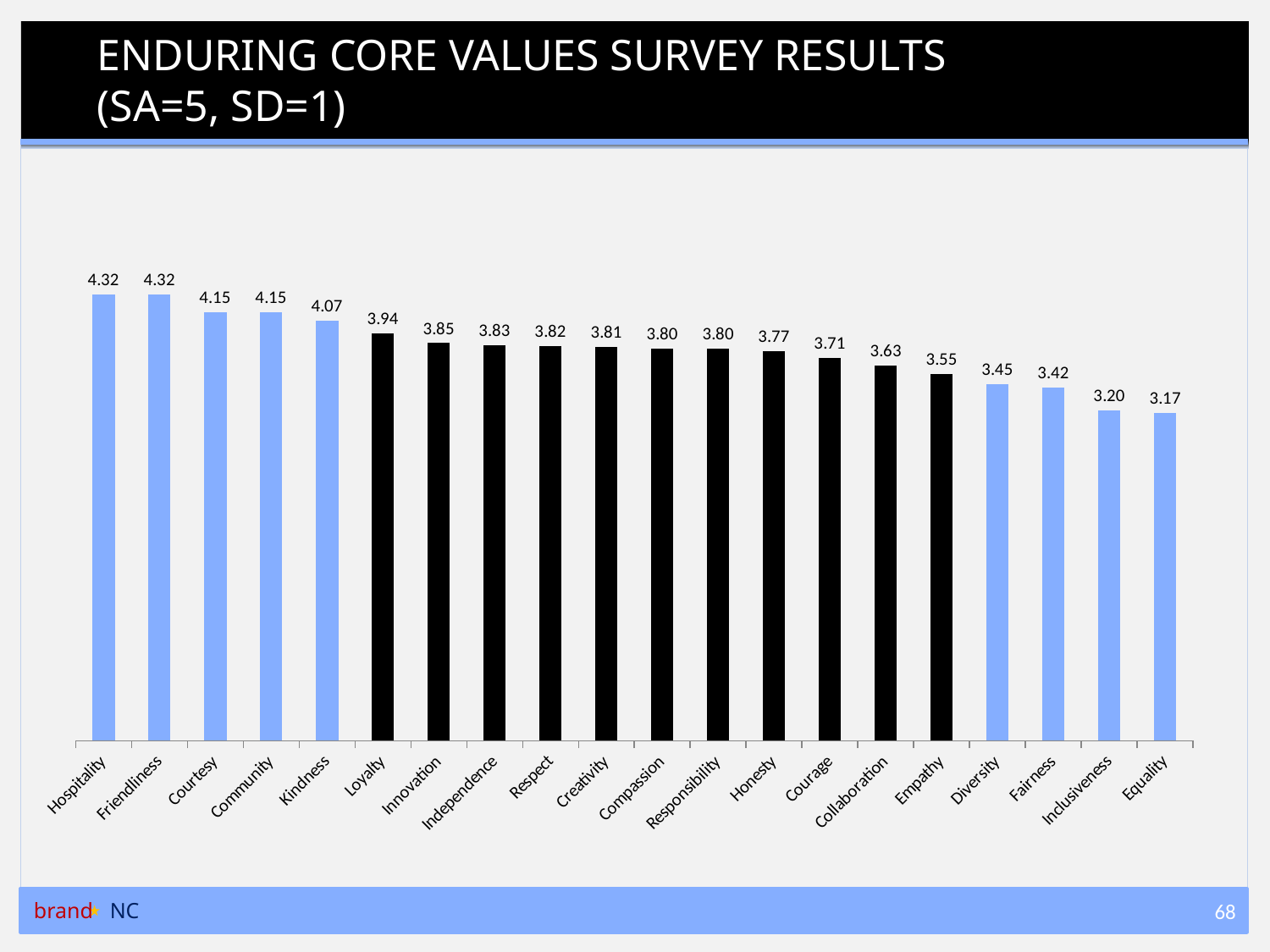
What is the value for Inclusiveness? 3.20 What is the value for Collaboration? 3.63 What is the value for Loyalty? 3.94 What is the difference between the values for Hospitality and Equality? 1.15 What kind of chart is shown on the slide? Bar chart Which has a higher value, Honesty or Empathy? Honesty Do the values rise or fall moving from left to right along the x axis? Fall Which category has the lowest value? Equality How many categories are shown in the chart? 20 Which has a higher value, Fairness or Courage? Courage What is the difference between the values for Courtesy and Diversity? 0.70 What is the value for Kindness? 4.07